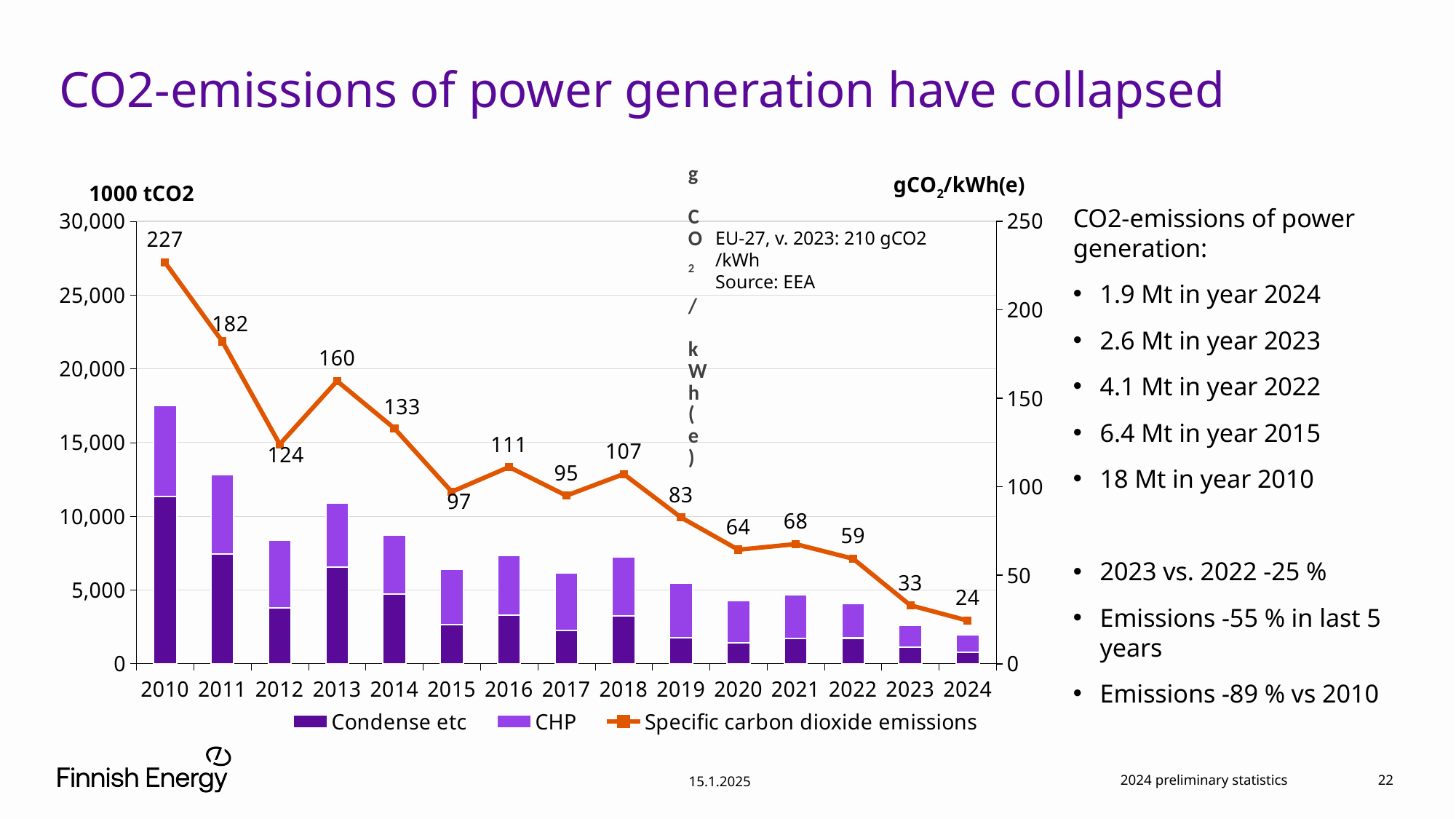
How many series does the legend list? 3 Is the total height of the stacked bar for 2010 greater or less than 15,000? greater Which year has the larger Specific carbon dioxide emissions value, 2012 or 2013? 2013 What is the difference between the Specific carbon dioxide emissions values for 2010 and 2024? 203 How many years are shown on the x axis? 15 What is the value of Specific carbon dioxide emissions for 2024? 24 Overall, do the Specific carbon dioxide emissions values rise or fall from 2010 to 2024? fall Is the total height of the stacked bar for 2024 greater or less than 5,000? less Which year has the lowest Specific carbon dioxide emissions value? 2024 What is the value of Specific carbon dioxide emissions for 2010? 227 Which year has the highest Specific carbon dioxide emissions value? 2010 What is the value of Specific carbon dioxide emissions for 2018? 107